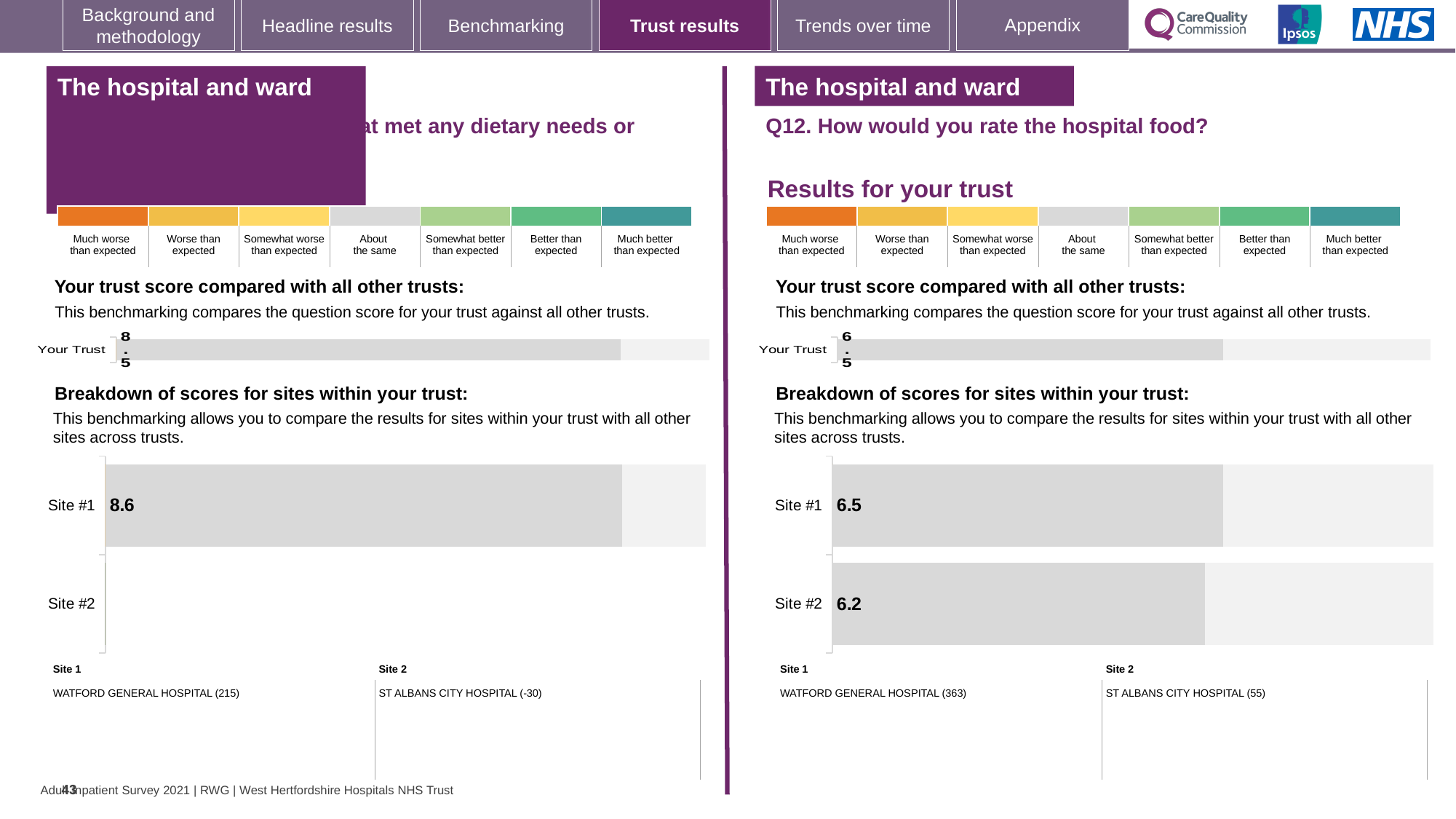
On the right half of the slide (Q12, hospital food), what is the score for Site #1 in the breakdown of sites chart? 6.5 On the right half of the slide (Q12, hospital food), which site has the higher score in the breakdown of sites chart? Site #1 On the left half of the slide, what is the score for Site #1 in the breakdown of sites chart? 8.6 What kind of chart is used to show the breakdown of scores for sites on the right half of the slide? Bar chart On the right half of the slide (Q12, hospital food), what is the score for Site #2 in the breakdown of sites chart? 6.2 On the left half of the slide, what is the score shown for Your Trust? 8.5 On the right half of the slide, which hospital is Site 1? WATFORD GENERAL HOSPITAL (363) On the left half of the slide, how many sites are listed in the breakdown of sites chart? 2 On the right half of the slide (Q12, hospital food), what is the score shown for Your Trust? 6.5 Which is larger: the Your Trust score on the left half of the slide or the Your Trust score on the right half (Q12)? Left half (8.5) On the right half of the slide, which hospital is Site 2? ST ALBANS CITY HOSPITAL (55) On the right half of the slide (Q12, hospital food), what is the difference between the Site #1 and Site #2 scores? 0.3